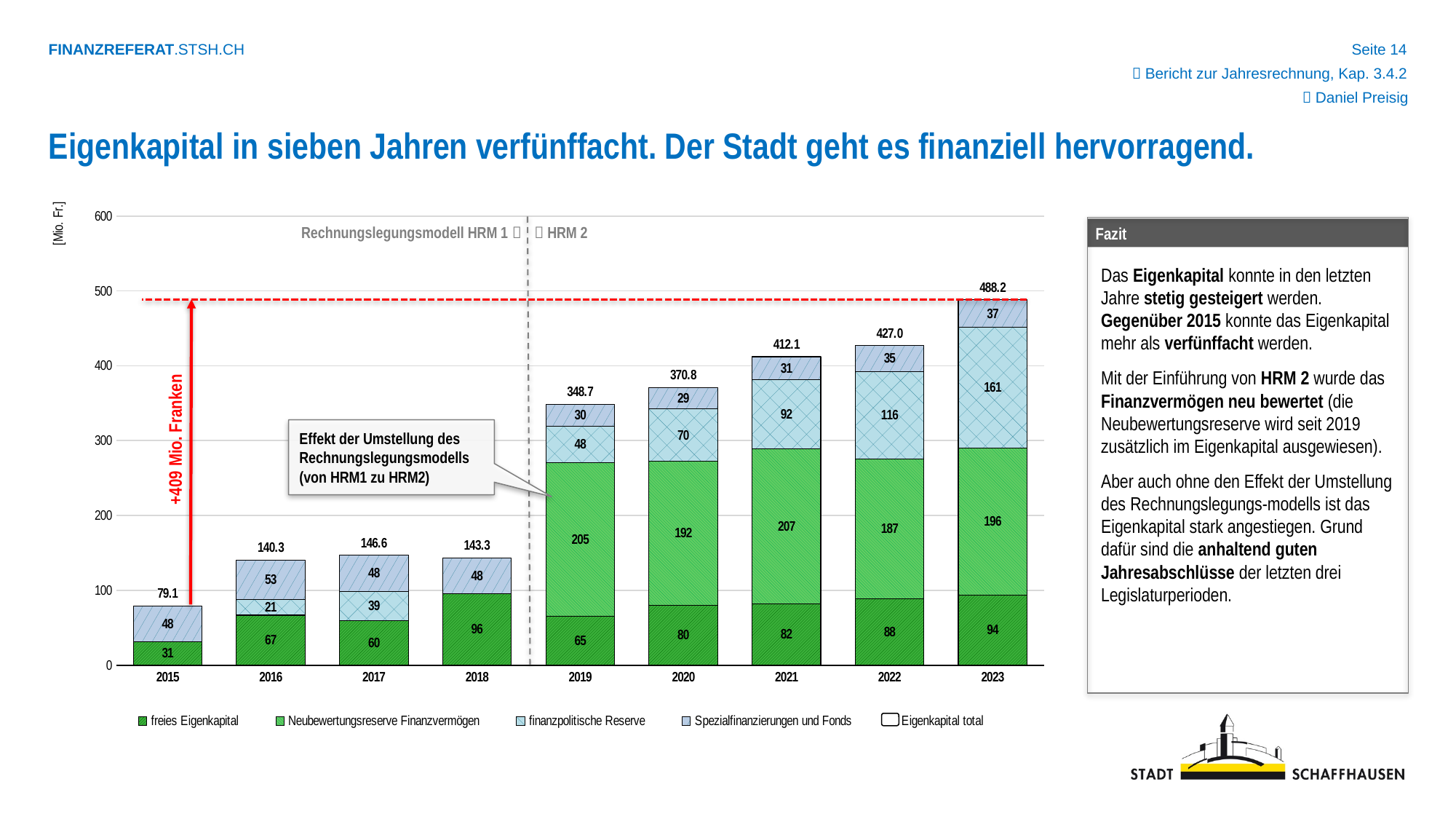
Which year has the highest total Eigenkapital? 2023 How many years are shown on the x axis? 9 What is the value of freies Eigenkapital in 2018? 96 Which year has the lowest total Eigenkapital? 2015 What is the value of finanzpolitische Reserve in 2022? 116 What is the unit shown on the y axis? [Mio. Fr.] Which is larger, the freies Eigenkapital in 2017 or in 2016? 2016 What is the total Eigenkapital shown for 2023? 488.2 How many entries does the legend list? 5 What is the difference between the total Eigenkapital in 2023 and in 2015? 409.1 What kind of chart is shown on the slide? Stacked bar chart What is the value of Neubewertungsreserve Finanzvermögen in 2021? 207